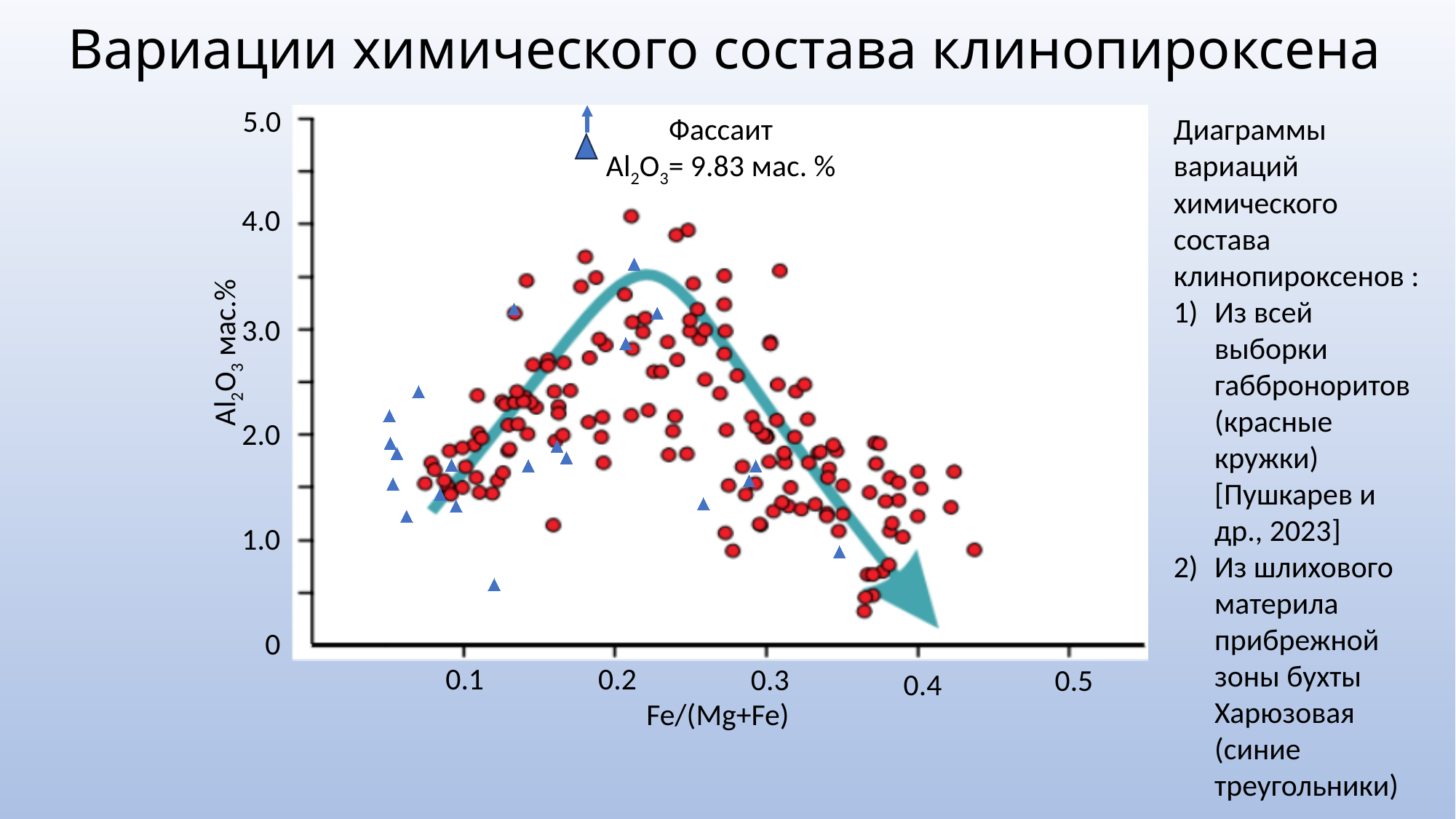
What kind of chart is shown on the slide? Scatter plot Following the trend arrow, do Al2O3 values rise or fall as Fe/(Mg+Fe) increases from 0.1 to 0.2? rise Following the trend arrow, do Al2O3 values rise or fall as Fe/(Mg+Fe) increases from 0.3 to 0.4? fall Is the lowest red circle on the chart greater or less than 1.0 мас.% Al2O3? less What is the highest tick value shown on the y axis? 5.0 Is the Al2O3 value of the Фассаит point greater or less than 5.0? greater Which marker symbol represents the gabbronorite samples? Red circles Which series contains the point with the highest Al2O3 value on the chart? Blue triangles What is the label of the x axis? Fe/(Mg+Fe) What is the highest tick value shown on the x axis? 0.5 How many groups of samples (series) are plotted on the chart? 2 What Al2O3 value is printed for the Фассаит (fassaite) point? 9.83 мас. %